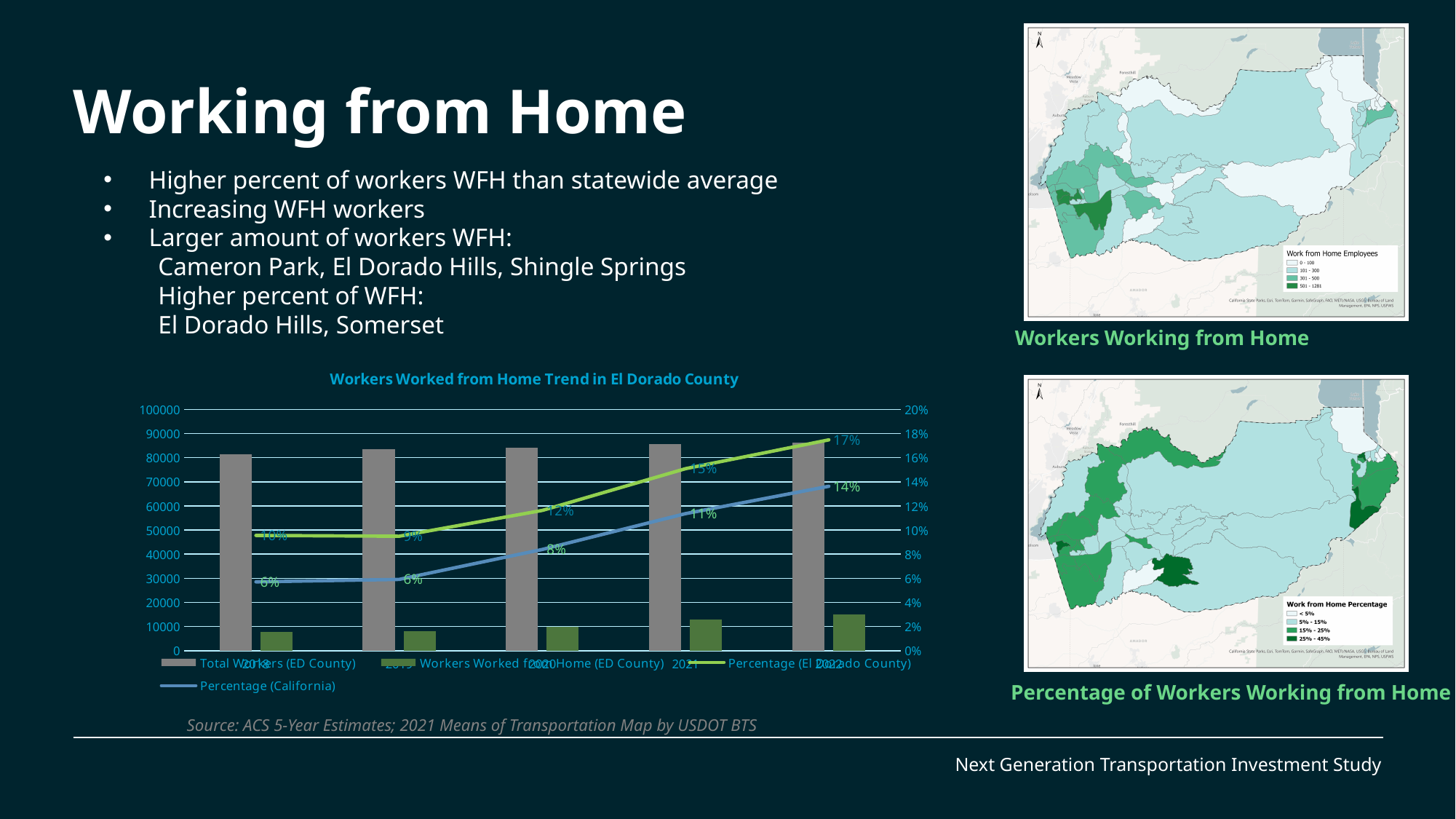
In the chart 'Workers Worked from Home Trend in El Dorado County', by how many percentage points does the El Dorado County percentage exceed the California percentage in 2022? 3% In the chart 'Workers Worked from Home Trend in El Dorado County', which is larger in 2019: Percentage (El Dorado County) or Percentage (California)? Percentage (El Dorado County) In the chart 'Workers Worked from Home Trend in El Dorado County', in which year is the Percentage (El Dorado County) lowest? 2019 How many years are shown on the x axis of the chart 'Workers Worked from Home Trend in El Dorado County'? 5 How many series does the legend of the chart 'Workers Worked from Home Trend in El Dorado County' list? 4 In the chart 'Workers Worked from Home Trend in El Dorado County', what is the Percentage (California) value for 2021? 11% In the chart 'Workers Worked from Home Trend in El Dorado County', is the Workers Worked from Home (ED County) value for 2022 greater or less than 20000? less In the chart 'Workers Worked from Home Trend in El Dorado County', is the Total Workers (ED County) value for 2018 greater or less than 70000? greater In the chart 'Workers Worked from Home Trend in El Dorado County', in which year is the Percentage (El Dorado County) highest? 2022 In the chart 'Workers Worked from Home Trend in El Dorado County', what is the Percentage (El Dorado County) value for 2022? 17% In the chart 'Workers Worked from Home Trend in El Dorado County', what is the Percentage (El Dorado County) value for 2020? 12% In the chart 'Workers Worked from Home Trend in El Dorado County', does the Percentage (California) line rise or fall from 2018 to 2022? rise